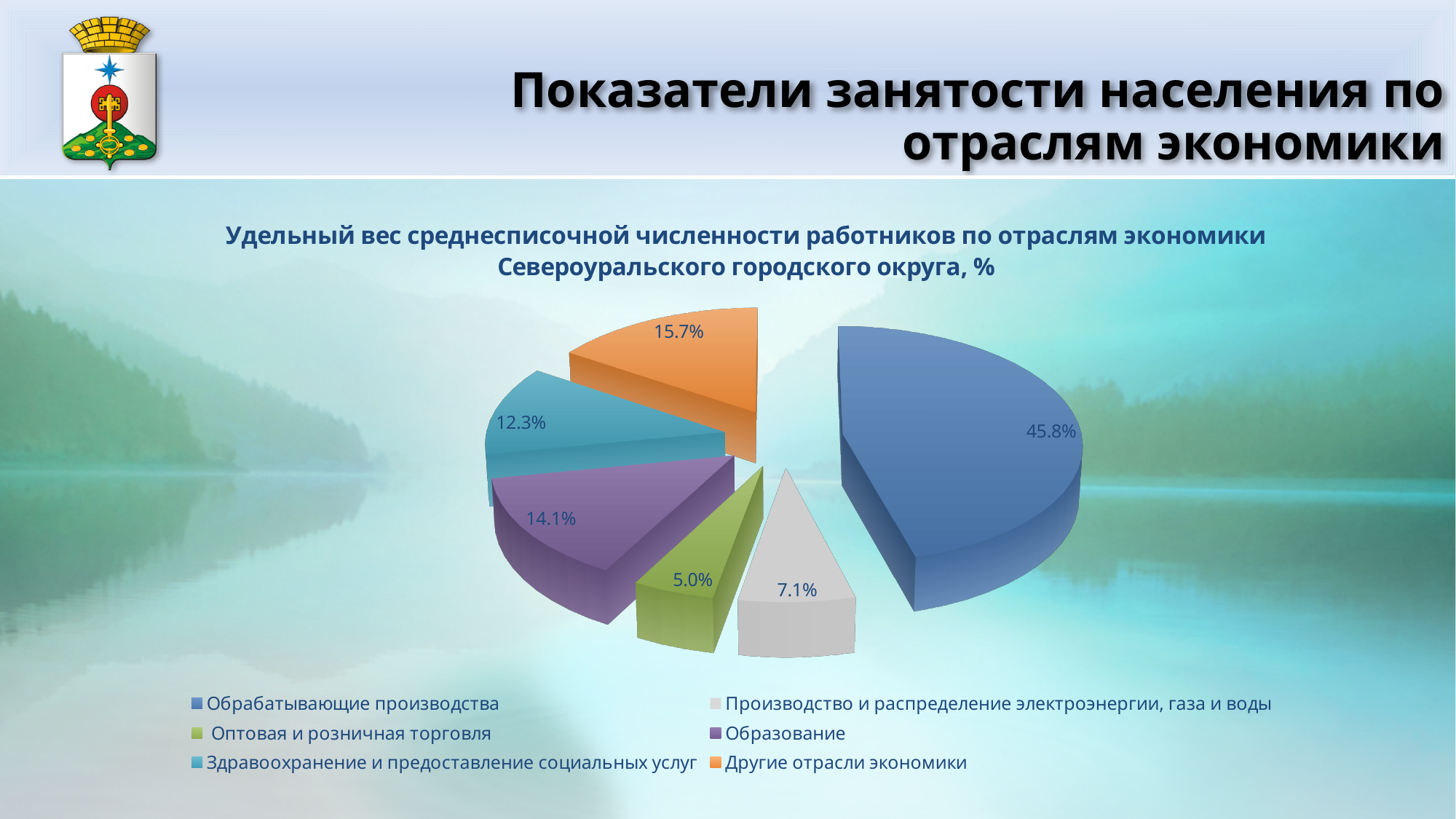
What share of workers is in Здравоохранение и предоставление социальных услуг? 12.3% What kind of chart is shown on the slide? pie chart What share of workers is in Производство и распределение электроэнергии, газа и воды? 7.1% What share of workers is in Оптовая и розничная торговля? 5.0% Which sector has the smallest share of workers? Оптовая и розничная торговля What is the difference between the shares of Другие отрасли экономики and Образование? 1.6% What colour is the slice for Другие отрасли экономики? orange What share of workers is in Образование? 14.1% Which is larger: the share of Здравоохранение и предоставление социальных услуг or the share of Производство и распределение электроэнергии, газа и воды? Здравоохранение и предоставление социальных услуг How many sectors are shown in the pie chart? 6 Which sector has the largest share of workers? Обрабатывающие производства What share of workers is in Обрабатывающие производства? 45.8%